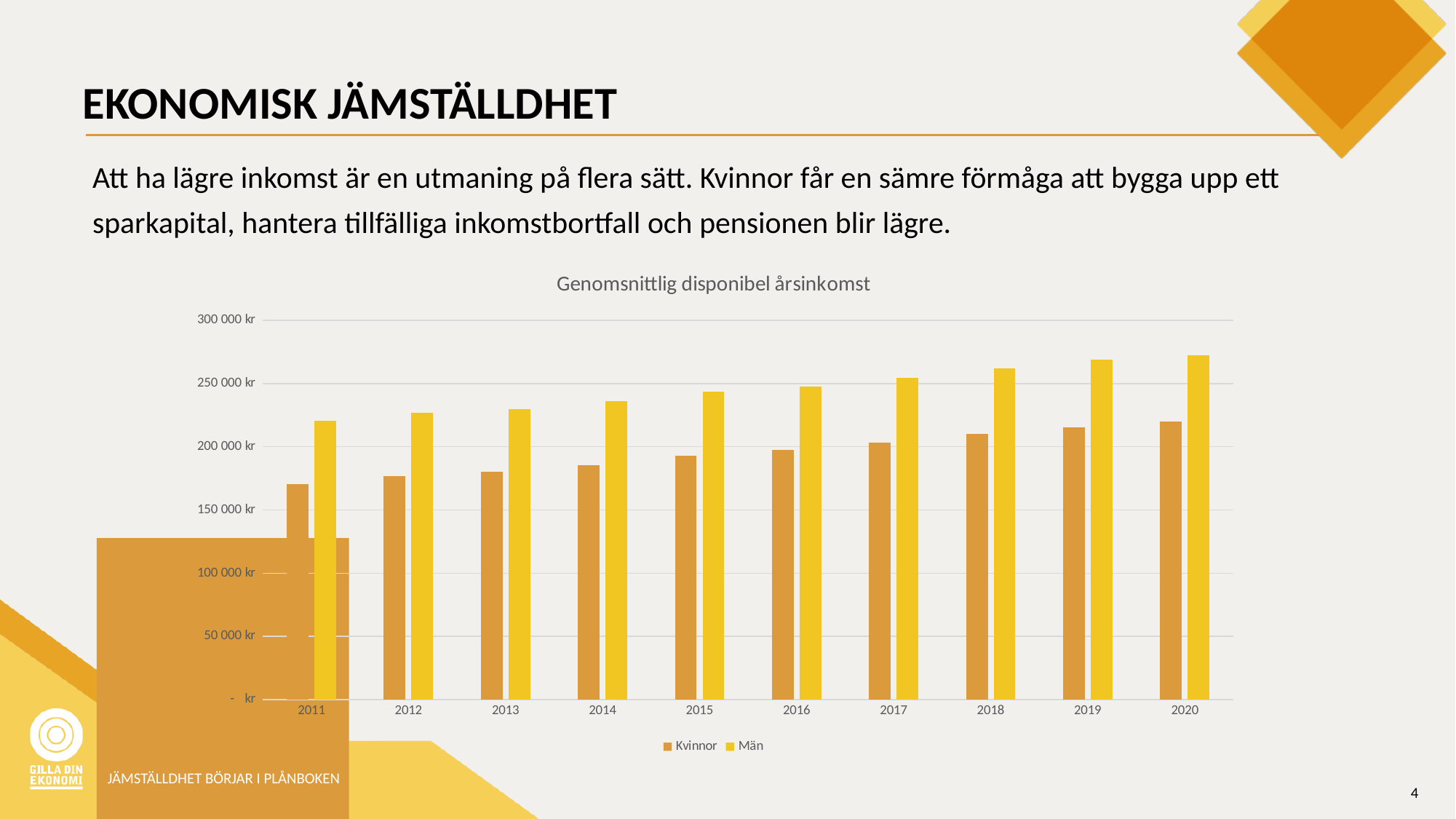
What type of chart is shown on the slide? Bar chart In which year is the value for Män highest? 2020 In 2015, which is larger, the value for Kvinnor or the value for Män? Män Is the value for Män in 2020 greater or less than 250 000 kr? greater How many years are shown on the x axis of the chart? 10 What is the title of the chart? Genomsnittlig disponibel årsinkomst Is the value for Män in 2011 greater or less than 250 000 kr? less How many series does the chart legend list? 2 Is the value for Kvinnor in 2020 greater or less than 200 000 kr? greater Do the values for Kvinnor rise or fall from 2011 to 2020? Rise In which year is the value for Kvinnor lowest? 2011